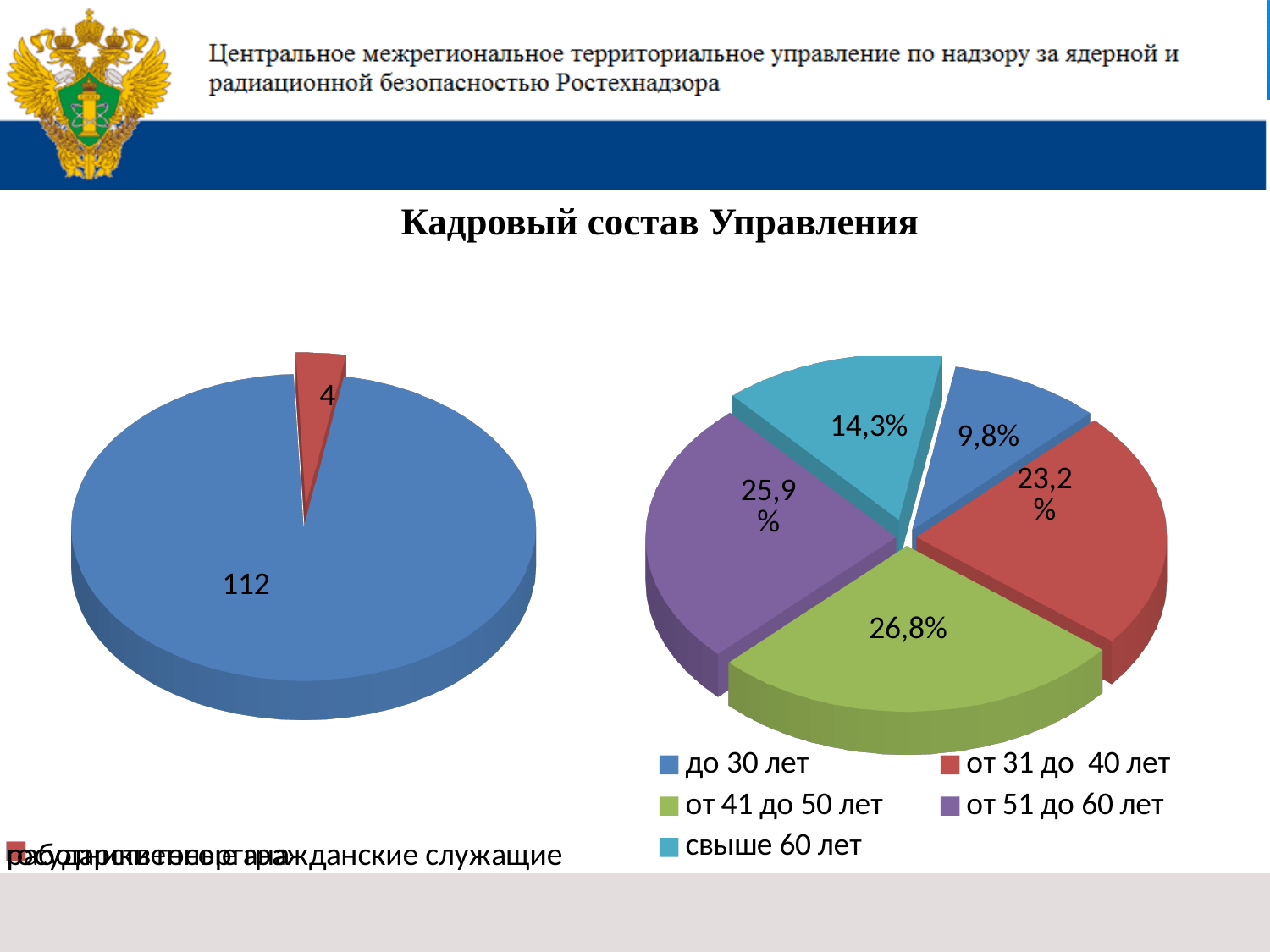
What type of chart is the left chart on the slide? Pie chart On the right pie chart, what is the difference between the shares for 'от 31 до 40 лет' and 'до 30 лет'? 13,4% On the right pie chart, what share is shown for the category 'от 41 до 50 лет'? 26,8% On the left pie chart, what value is shown on the large blue slice? 112 On the right pie chart, what share is shown for the category 'свыше 60 лет'? 14,3% How many categories does the legend of the right pie chart list? 5 On the right pie chart, which age category has the largest share? от 41 до 50 лет On the right pie chart, which age category has the smallest share? до 30 лет On the right pie chart, what share is shown for the category 'до 30 лет'? 9,8% On the right pie chart, what share is shown for the category 'от 51 до 60 лет'? 25,9% On the right pie chart, which is larger: the share for 'от 31 до 40 лет' or for 'свыше 60 лет'? от 31 до 40 лет On the left pie chart, what is the total of the two slice values shown? 116